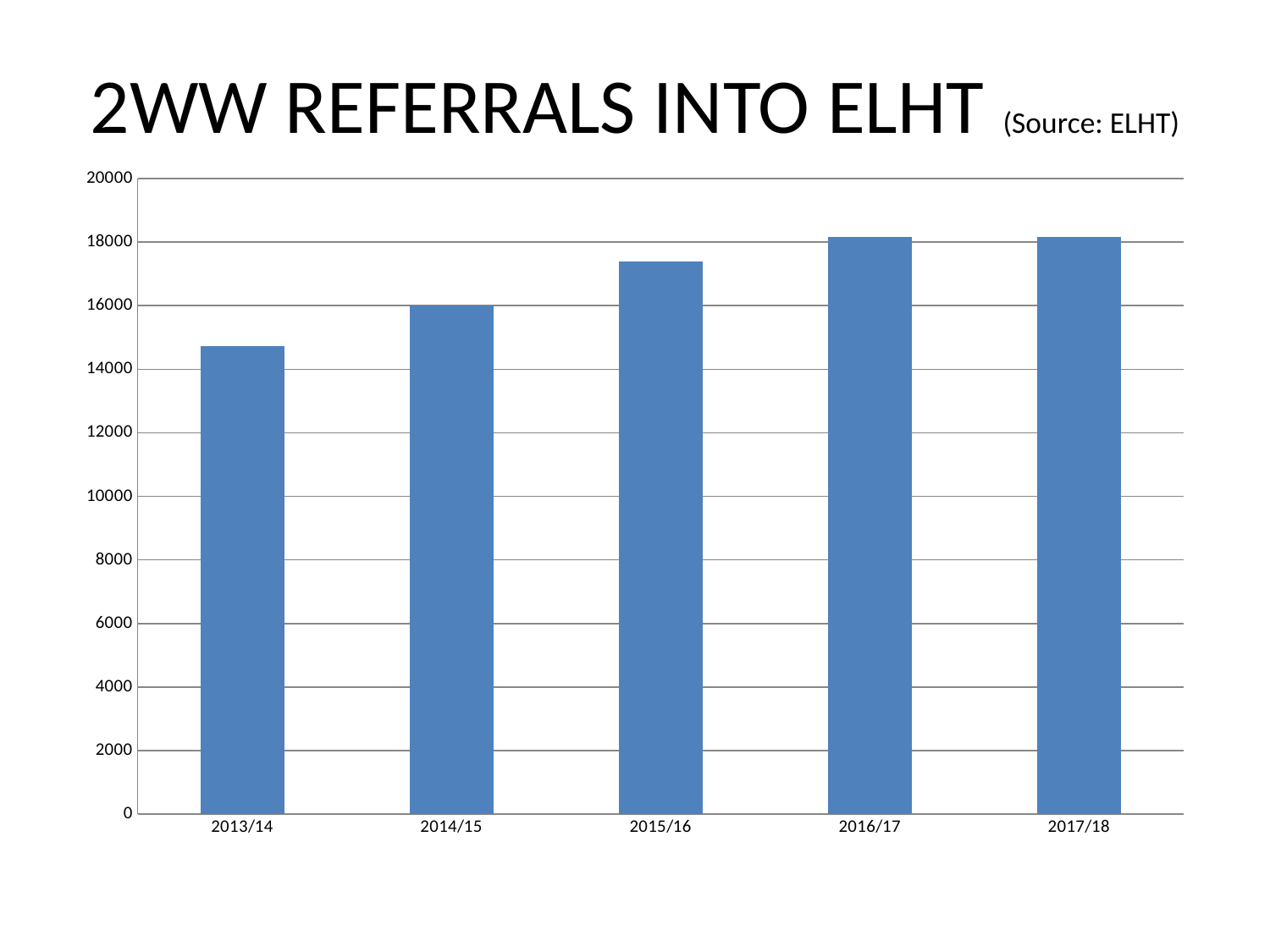
What is the title of the chart? 2WW REFERRALS INTO ELHT What kind of chart is shown on the slide? bar chart How many years are shown on the x axis of the chart? 5 Do the values generally rise or fall from 2013/14 to 2017/18? rise Which is larger, the value for 2013/14 or the value for 2016/17? 2016/17 Which year has the lowest number of 2WW referrals into ELHT? 2013/14 Is the value for 2015/16 greater or less than 18000? less Which is larger, the value for 2014/15 or the value for 2015/16? 2015/16 Is the value for 2017/18 greater or less than 16000? greater Is the value for 2016/17 greater or less than 18000? greater